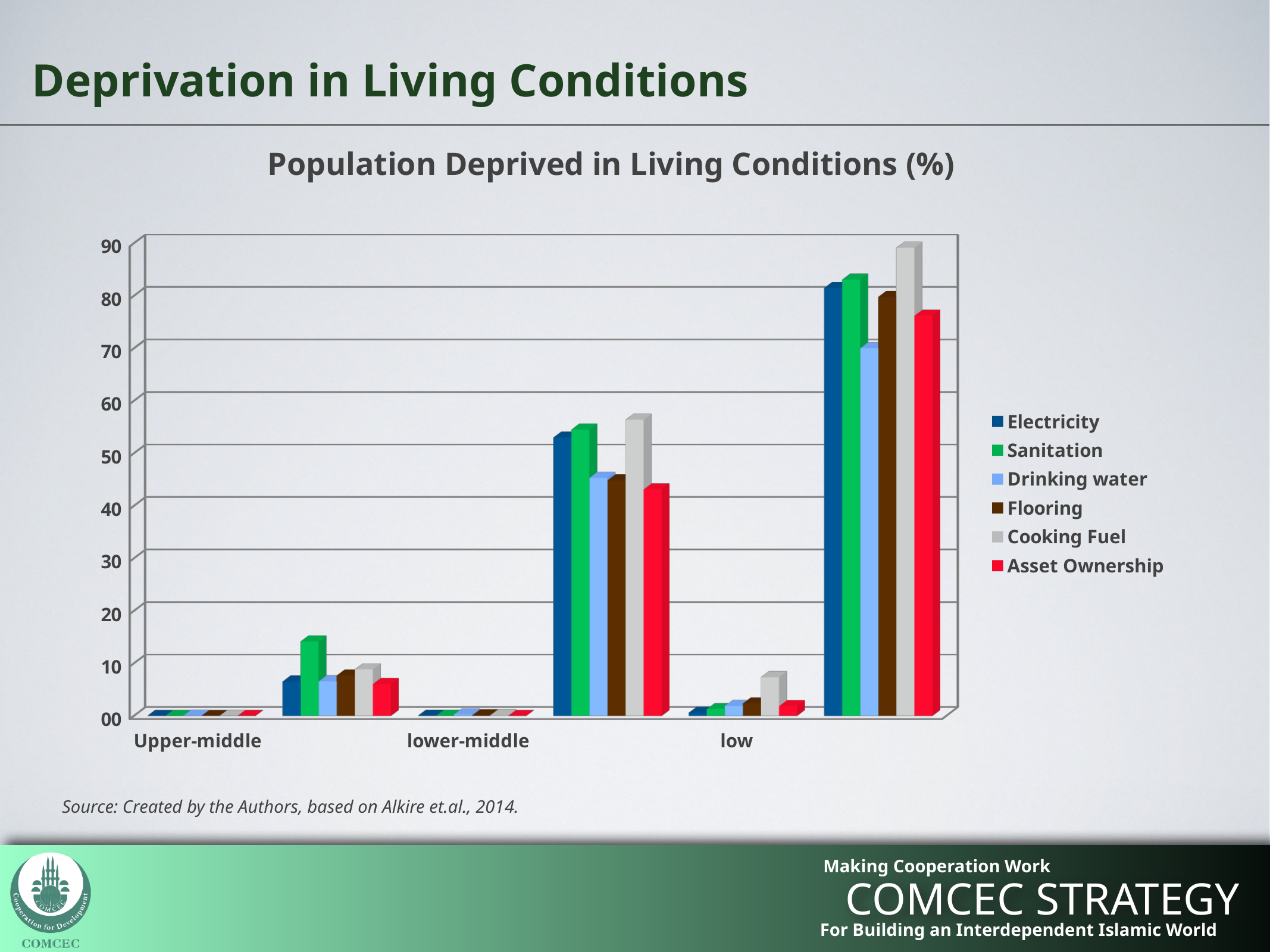
What kind of chart is shown on the slide? bar chart Is the Asset Ownership value in the middle tall group of bars greater or less than 50? less How many category labels are shown on the x axis? 3 How many series does the legend list? 6 Do the bar heights generally rise or fall moving from left to right across the chart? rise Is the Electricity value in the middle tall group of bars greater or less than 50? greater Which series is shown in red in the legend? Asset Ownership In the rightmost group of bars, which series has the lowest value? Drinking water Is the Asset Ownership value in the rightmost group of bars greater or less than 80? less Which series has the tallest bar anywhere in the chart? Cooking Fuel What is the title of the chart? Population Deprived in Living Conditions (%)